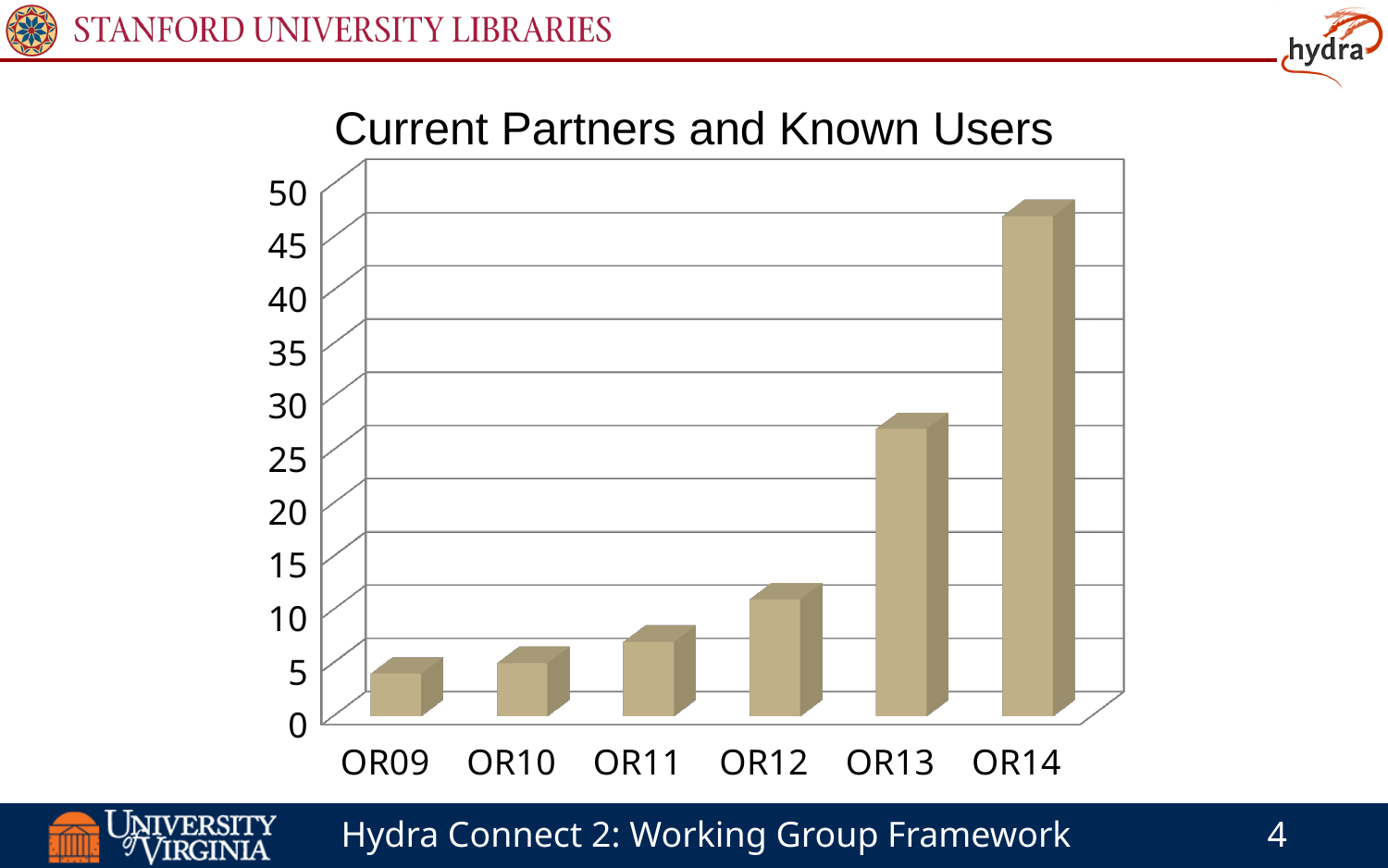
Is the value for OR09 greater or less than 10? less What kind of chart is shown on the slide? bar chart Is the value for OR12 greater or less than 15? less Is the value for OR14 greater or less than 40? greater Which has a larger value, OR11 or OR14? OR14 How many categories are shown on the x axis of the chart? 6 Do the values rise or fall from OR09 to OR14? rise Which has a larger value, OR13 or OR12? OR13 Which category has the highest value in the chart? OR14 What is the title of the chart? Current Partners and Known Users